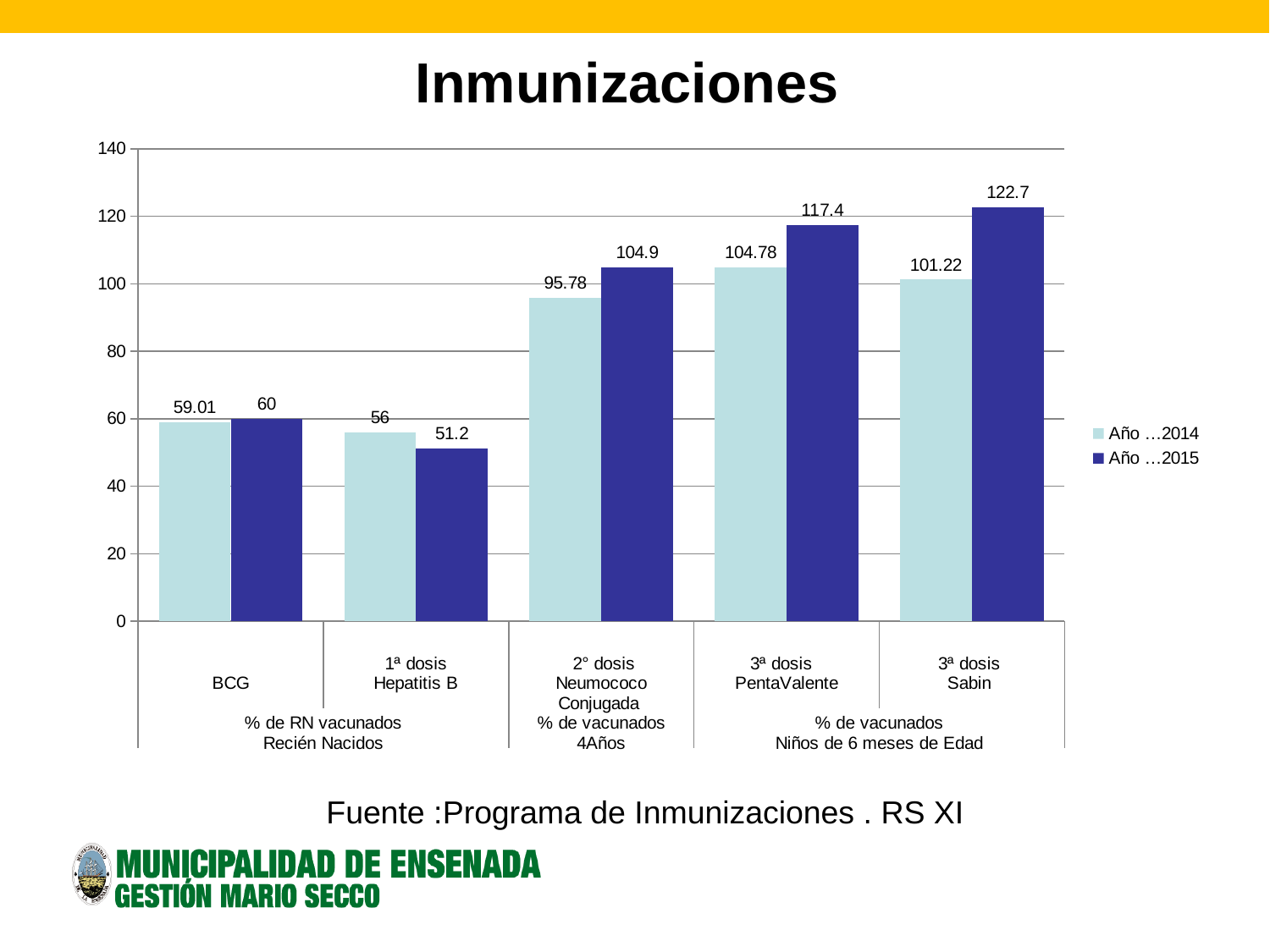
How many categories are shown on the x axis? 5 Is the Año …2015 value for 3ª dosis PentaValente greater or less than 100? greater What is the value for BCG in the Año …2014 series? 59.01 How many series does the legend list? 2 For 1ª dosis Hepatitis B, which series has the larger value, Año …2014 or Año …2015? Año …2014 Which category has the lowest value in the Año …2014 series? 1ª dosis Hepatitis B What is the title of the chart? Inmunizaciones What is the value for 1ª dosis Hepatitis B in the Año …2015 series? 51.2 What kind of chart is shown on the slide? bar chart Which category has the highest value in the Año …2015 series? 3ª dosis Sabin What is the difference between the Año …2015 and Año …2014 values for 3ª dosis Sabin? 21.48 What is the value for 3ª dosis Sabin in the Año …2015 series? 122.7